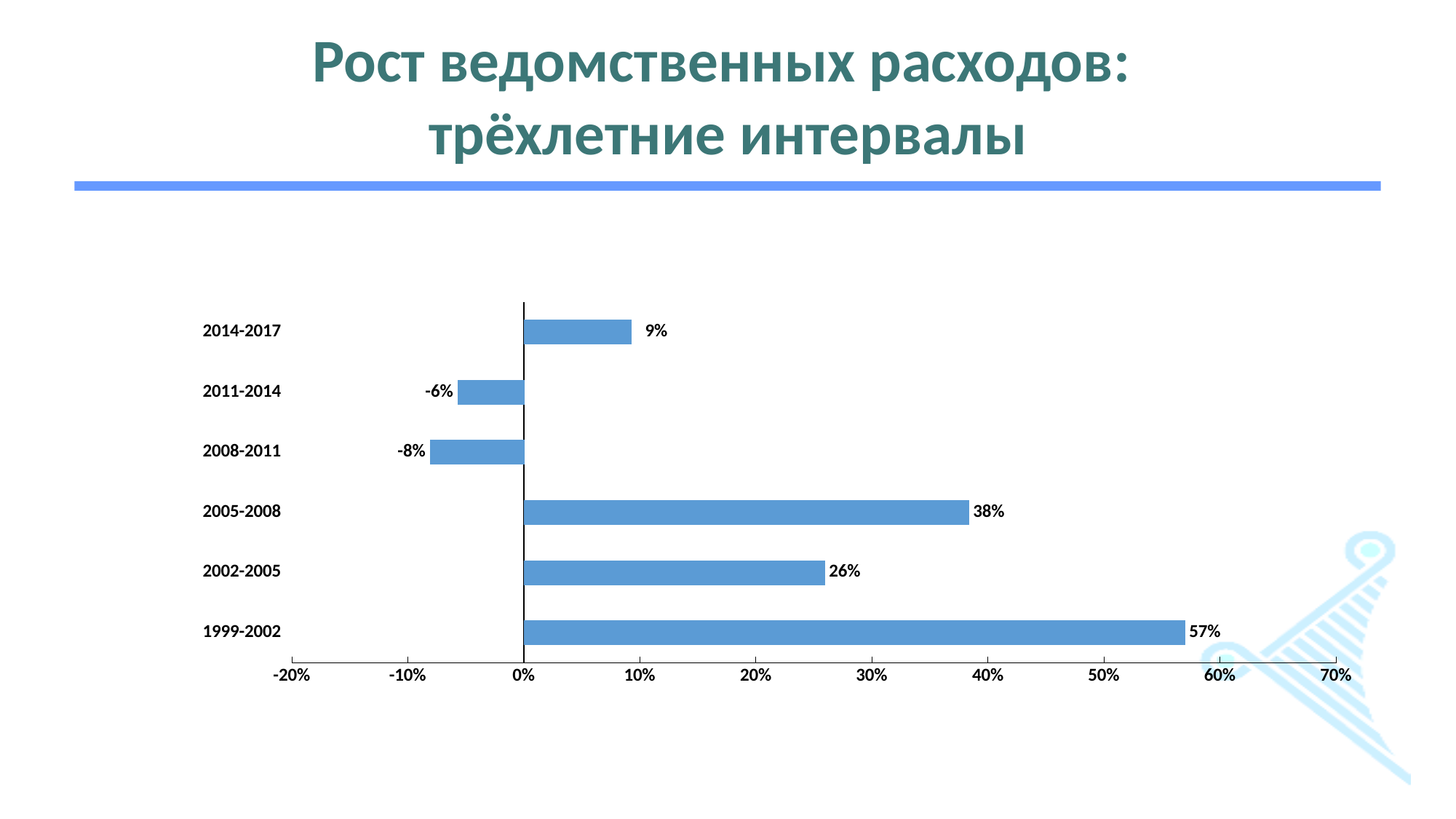
Which is larger, the value for 2002-2005 or the value for 2014-2017? 2002-2005 How many intervals are shown on the chart? 6 What is the value for 1999-2002? 57% What kind of chart is shown on the slide? bar chart Which interval has the highest value? 1999-2002 What is the value for 2008-2011? -8% What is the difference between the values for 2005-2008 and 2002-2005? 12% What is the value for 2014-2017? 9% Is the value for 2005-2008 greater or less than 30%? greater What is the title of the slide? Рост ведомственных расходов: трёхлетние интервалы How many intervals have a negative value? 2 Which interval has the lowest value? 2008-2011